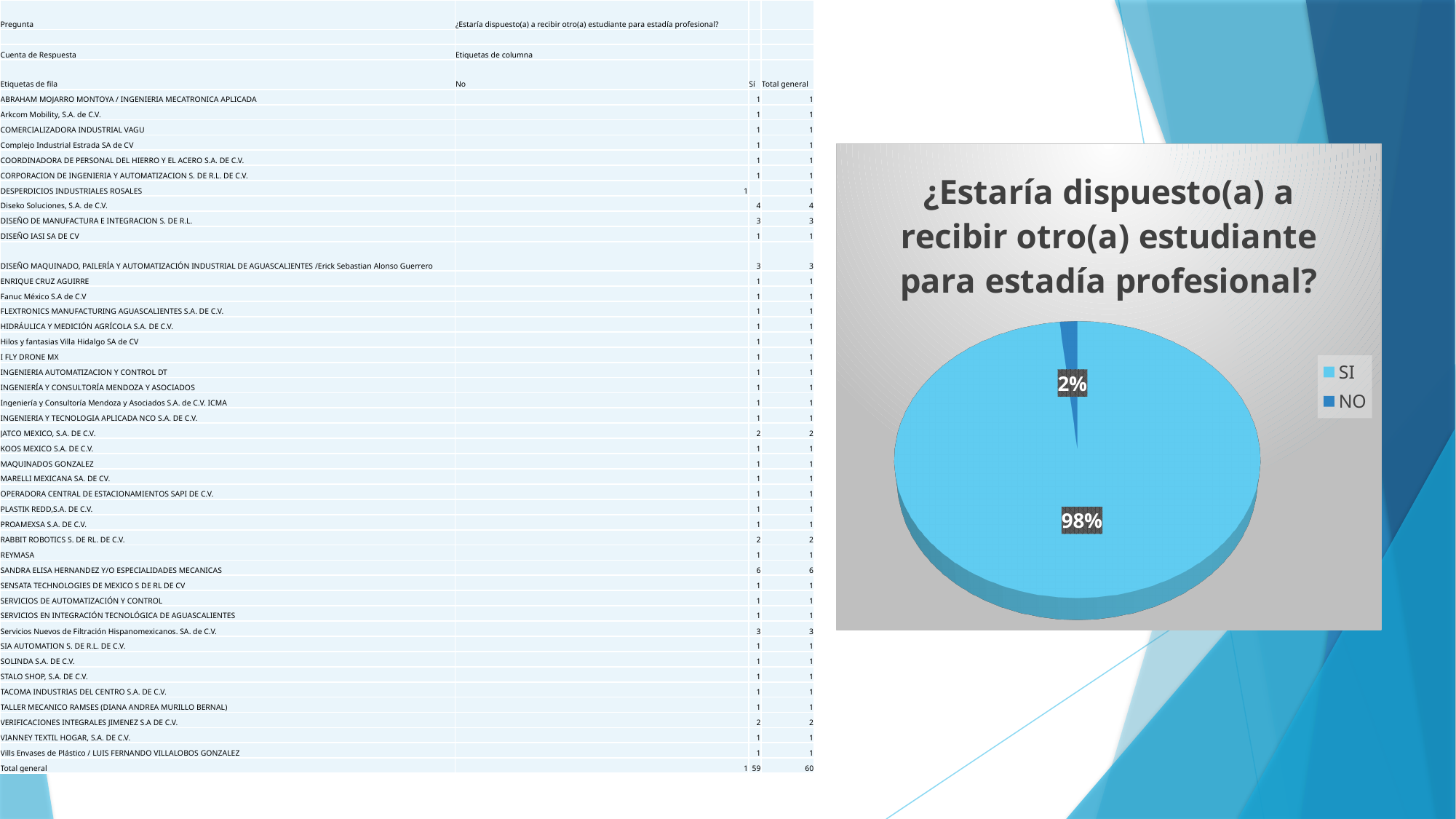
How many entries does the legend of the pie chart list? 2 What share of the pie chart does the SI slice represent? 98% What is the title of the pie chart? ¿Estaría dispuesto(a) a recibir otro(a) estudiante para estadía profesional? What is the difference in percentage points between the SI and NO slices of the pie chart? 96 How many slices does the pie chart have? 2 What kind of chart is shown on the slide? pie chart Which is larger in the pie chart, SI or NO? SI What are the two legend entries of the pie chart? SI and NO Which slice of the pie chart is the largest? SI Which slice of the pie chart is the smallest? NO What share of the pie chart does the NO slice represent? 2%